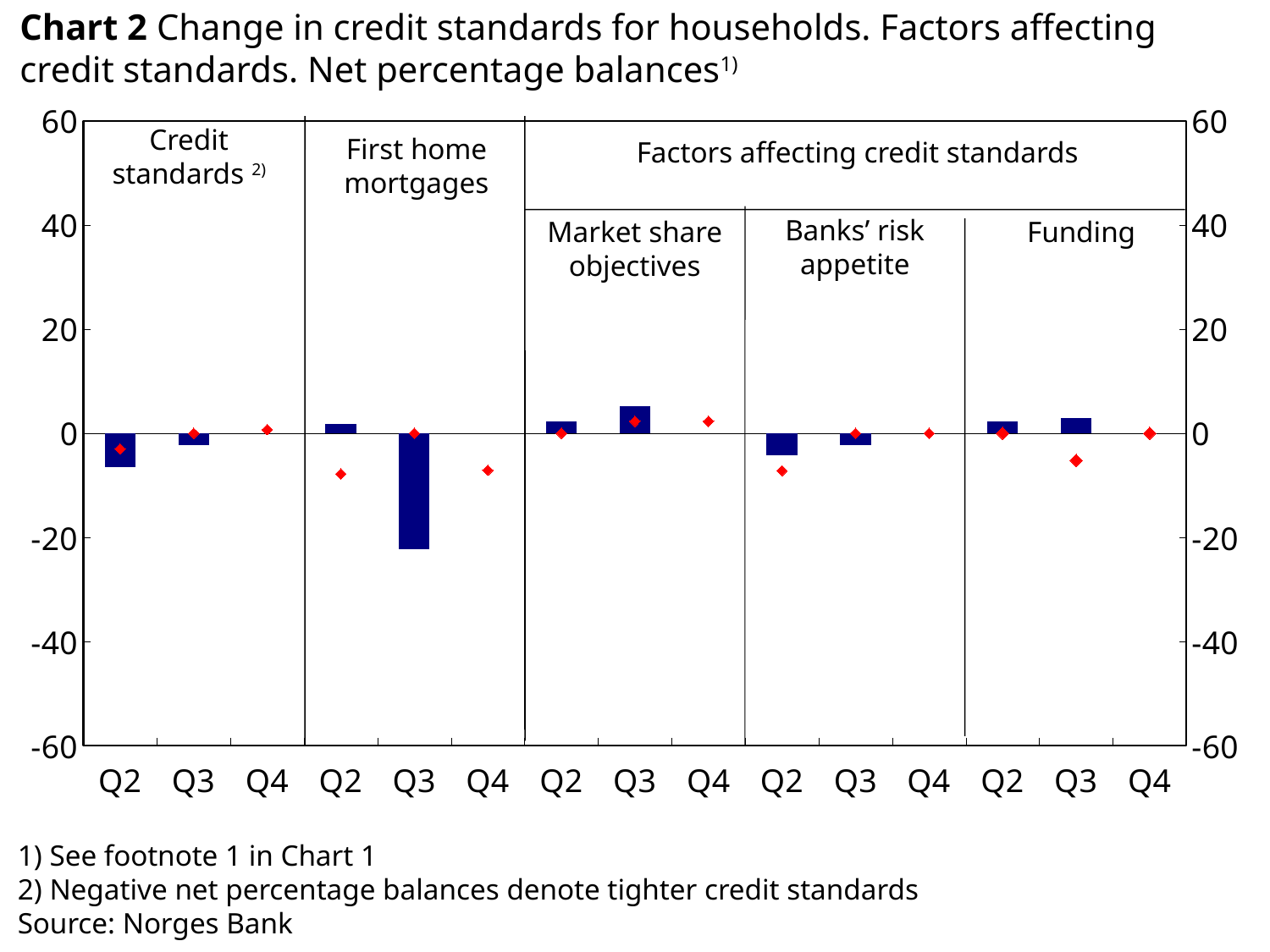
In the 'Credit standards' panel, is the Q2 bar greater or less than 0? less In the 'Funding' panel, is the Q3 bar greater or less than 0? greater In the 'First home mortgages' panel, is the Q3 bar greater or less than 0? less What is the source given for the chart? Norges Bank Which quarter has the lowest bar in the whole chart? Q3 under First home mortgages In the 'Credit standards' panel, which bar is lower, Q2 or Q3? Q2 How many quarters are shown in each panel of the chart? 3 In the 'First home mortgages' panel, which bar is lower, Q2 or Q3? Q3 What kind of chart is Chart 2? combination bar and line chart (bars with red diamond markers) How many sub-panels are listed under 'Factors affecting credit standards'? 3